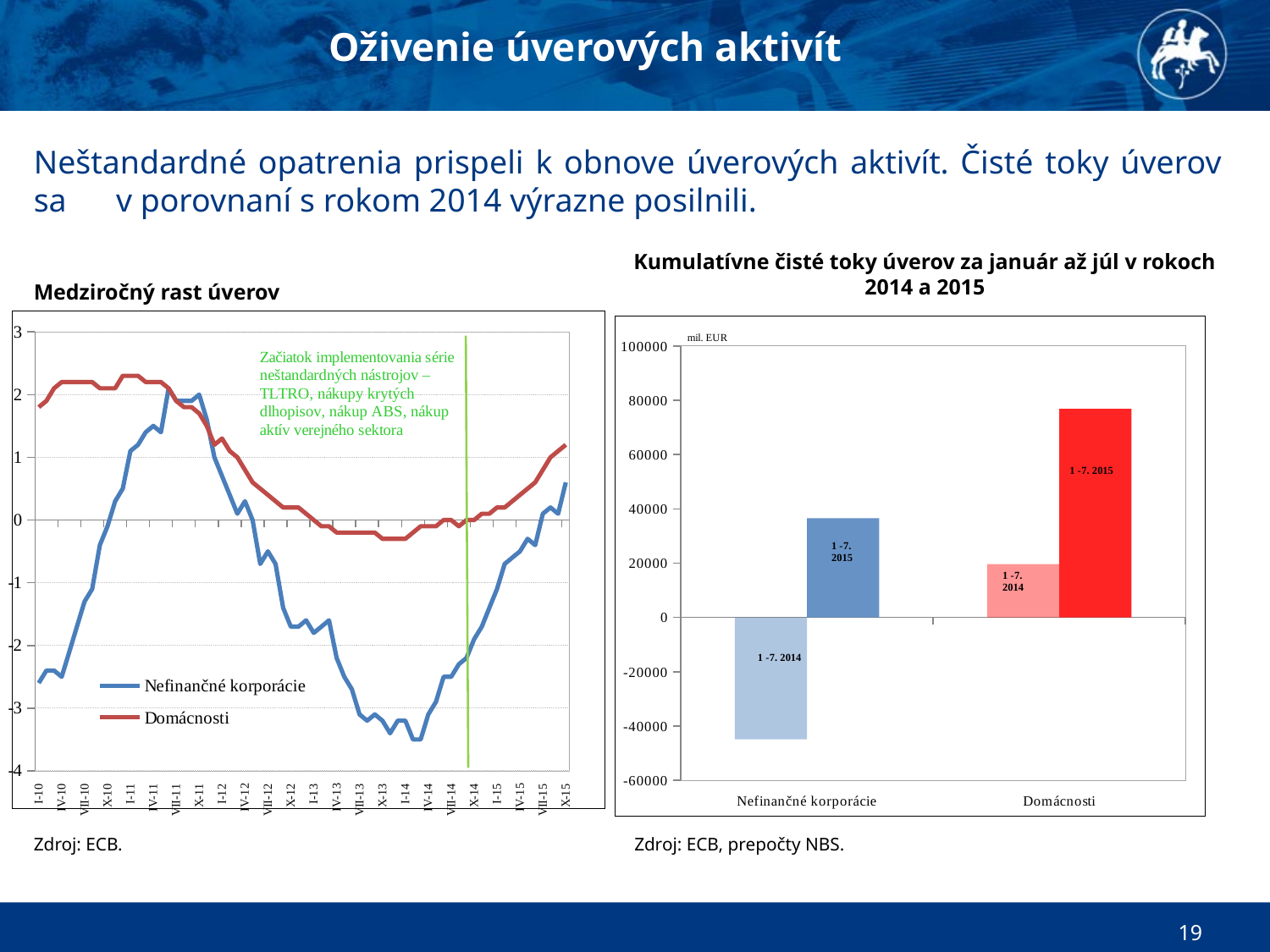
In the chart 'Kumulatívne čisté toky úverov za január až júl v rokoch 2014 a 2015', is the value for Domácnosti in 1-7. 2015 greater or less than 60000? greater How many series does the legend of the chart 'Medziročný rast úverov' list? 2 In the chart 'Kumulatívne čisté toky úverov za január až júl v rokoch 2014 a 2015', which bar is the highest? Domácnosti, 1-7. 2015 In the chart 'Medziročný rast úverov', which series is shown in red? Domácnosti In the chart 'Kumulatívne čisté toky úverov za január až júl v rokoch 2014 a 2015', which bar is the lowest? Nefinančné korporácie, 1-7. 2014 In the chart 'Kumulatívne čisté toky úverov za január až júl v rokoch 2014 a 2015', is the value for Nefinančné korporácie in 1-7. 2014 greater or less than -40000? less What kind of chart is the chart titled 'Medziročný rast úverov'? line chart What kind of chart is the chart titled 'Kumulatívne čisté toky úverov za január až júl v rokoch 2014 a 2015'? bar chart In the chart 'Kumulatívne čisté toky úverov za január až júl v rokoch 2014 a 2015', which is larger: Domácnosti in 1-7. 2015 or Nefinančné korporácie in 1-7. 2015? Domácnosti in 1-7. 2015 In the chart 'Kumulatívne čisté toky úverov za január až júl v rokoch 2014 a 2015', how many categories are shown on the x axis? 2 In the chart 'Medziročný rast úverov', does the Nefinančné korporácie series rise or fall between I-14 and X-15? rise In the chart 'Kumulatívne čisté toky úverov za január až júl v rokoch 2014 a 2015', is the value for Nefinančné korporácie in 1-7. 2015 greater or less than 20000? greater